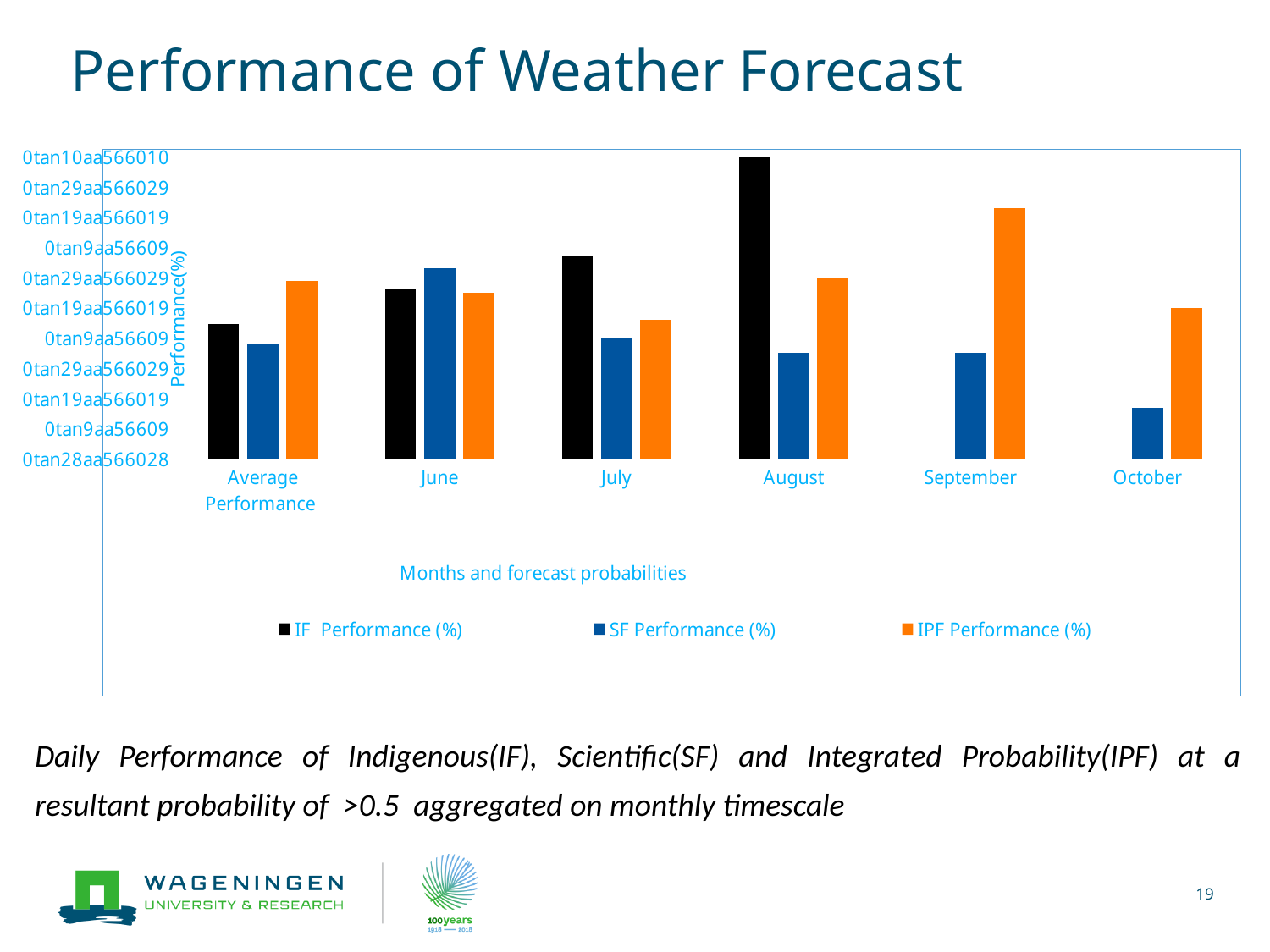
In September, which is larger: SF Performance (%) or IPF Performance (%)? IPF Performance (%) In which category is the SF Performance (%) bar the highest? June In which month is the SF Performance (%) bar the lowest? October In which month is the IF Performance (%) bar the highest? August Does the IF Performance (%) series rise or fall from June to August? rise How many series does the chart legend list? 3 In which month is the IPF Performance (%) bar the highest? September What kind of chart is shown on the slide? bar chart In August, which is larger: IF Performance (%) or SF Performance (%)? IF Performance (%) What is the title of the slide containing the chart? Performance of Weather Forecast How many categories are shown on the x axis of the chart? 6 What is the x-axis title of the chart? Months and forecast probabilities